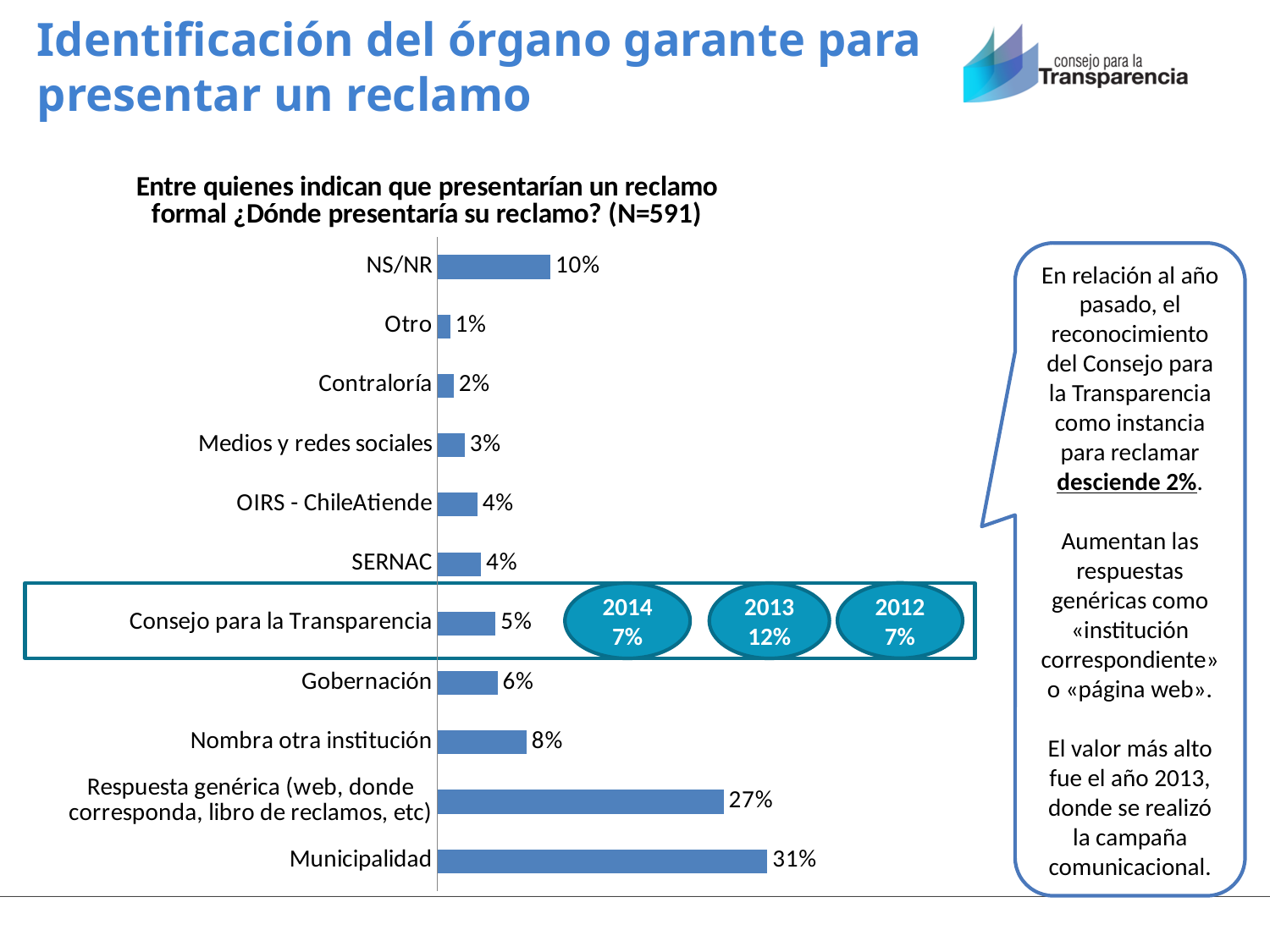
Which category has the highest value? Municipalidad What is the difference between the values for Municipalidad and Respuesta genérica (web, donde corresponda, libro de reclamos, etc)? 4% What is the value for Respuesta genérica (web, donde corresponda, libro de reclamos, etc)? 27% What kind of chart is shown on the slide? Bar chart How many categories does the chart show? 11 Which category has the lowest value? Otro Which is larger, the value for Gobernación or the value for Nombra otra institución? Nombra otra institución What is the sample size (N) stated in the chart title? N=591 What is the value for Municipalidad? 31% What is the value for NS/NR? 10% What is the value for Consejo para la Transparencia? 5% What is the difference between the values for NS/NR and Contraloría? 8%